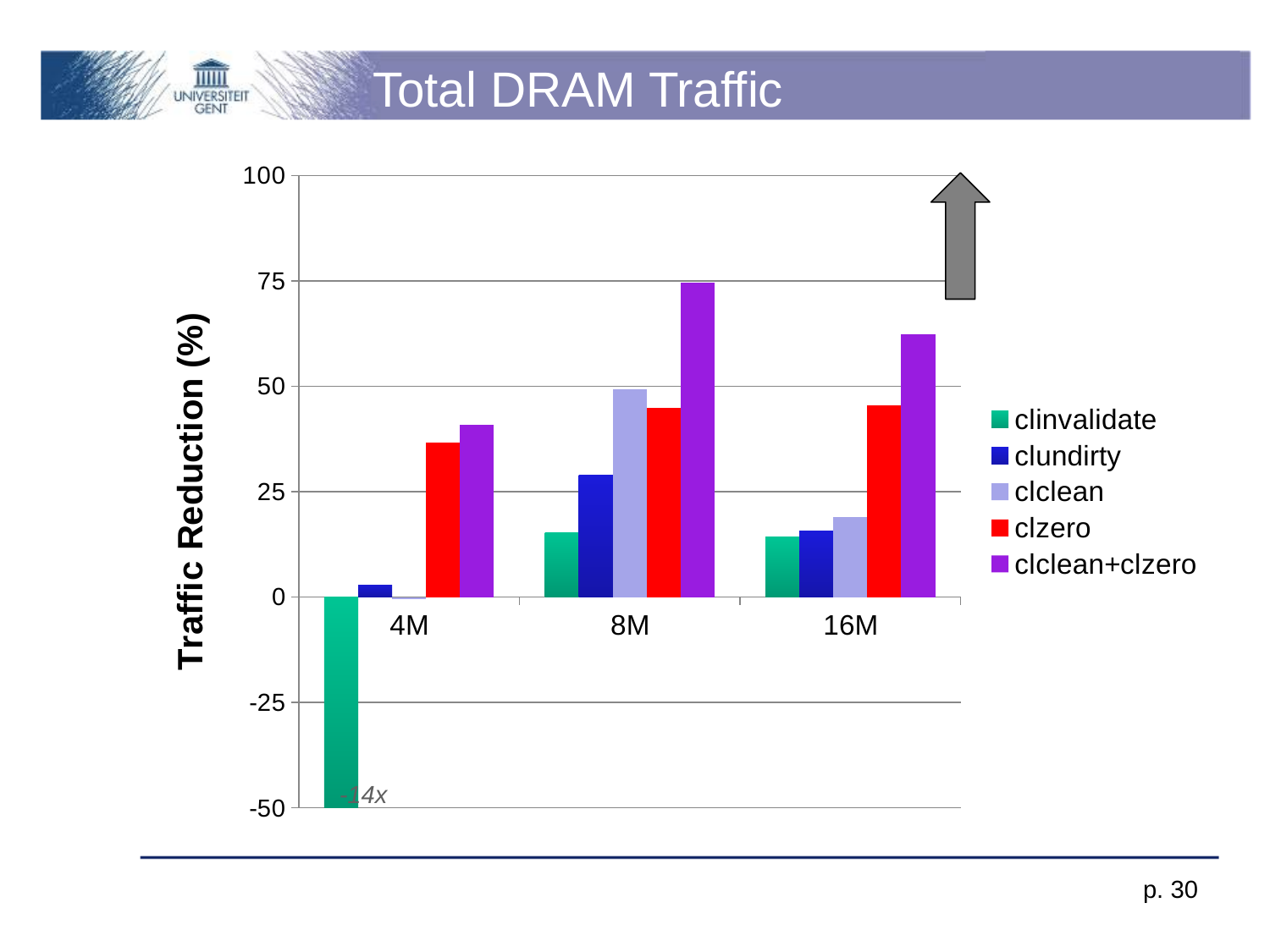
Which series has the highest traffic reduction at 8M? clclean+clzero Is the value for clundirty at 8M greater or less than 25? greater Which series has the lowest traffic reduction at 4M? clinvalidate Does the value for clclean+clzero rise or fall from 4M to 8M? rise Is the value for clzero at 4M greater or less than 25? greater What kind of chart is shown on the slide? bar chart Which is larger for clundirty: the value at 8M or the value at 16M? 8M Is the value for clclean+clzero at 8M greater or less than 50? greater What is the title of the y axis? Traffic Reduction (%) How many series does the legend list? 5 How many categories are shown on the x axis? 3 At 16M, which is larger: clzero or clclean? clzero